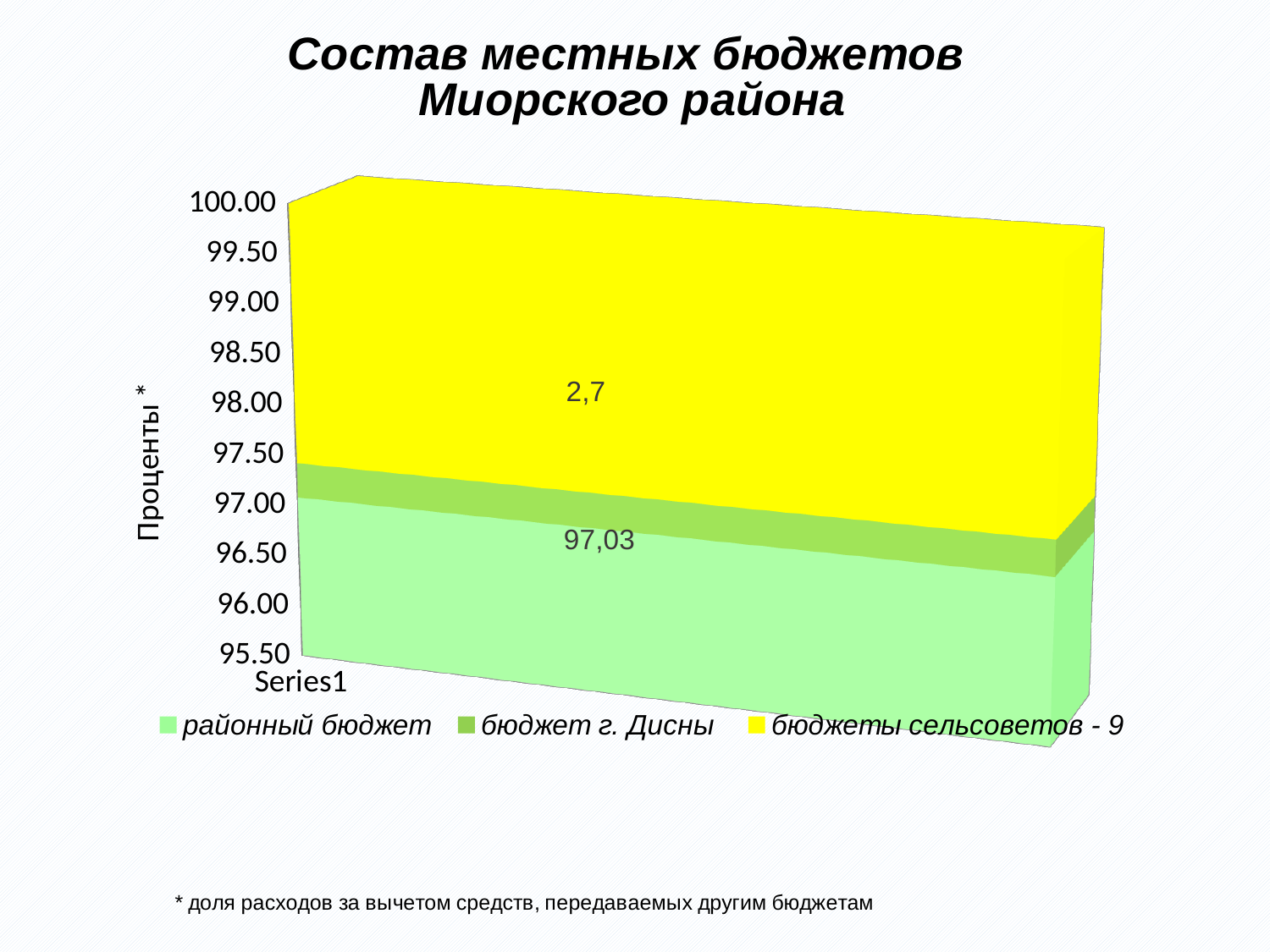
What is the value labelled for районный бюджет? 97,03 Which is larger, the value for районный бюджет or the value for бюджеты сельсоветов - 9? районный бюджет What is the title of the chart? Состав местных бюджетов Миорского района Which series has the largest segment in the bar? районный бюджет How many series does the legend list? 3 What is the value labelled for бюджеты сельсоветов - 9? 2,7 What kind of chart is shown on the slide? area chart What is the label of the vertical axis? Проценты * Which series has the smallest segment in the bar? бюджет г. Дисны How many categories are shown on the x axis? 1